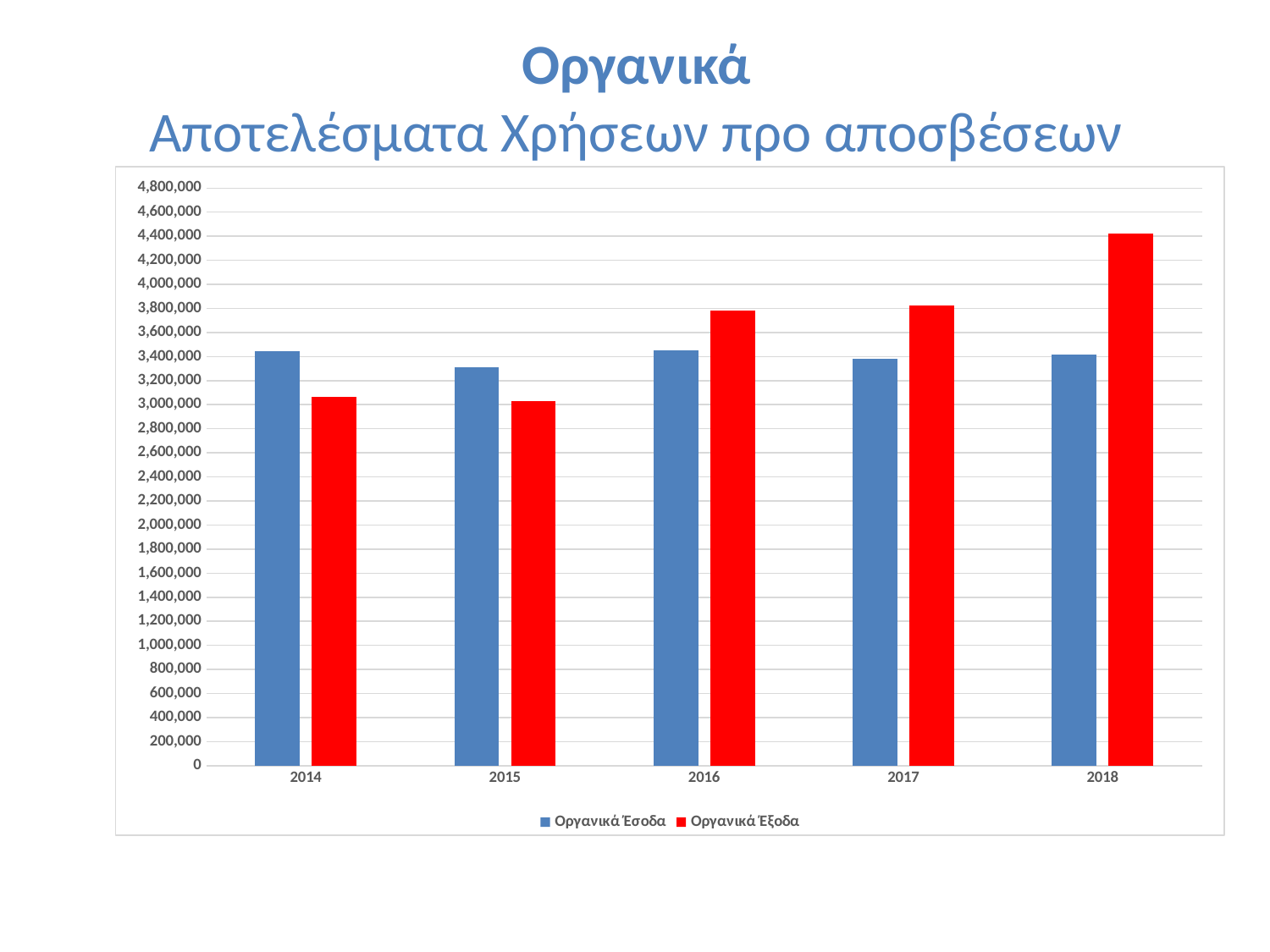
How many years are shown on the x axis of the chart? 5 How many series does the legend list? 2 In 2014, which is larger: Οργανικά Έσοδα or Οργανικά Έξοδα? Οργανικά Έσοδα In 2018, which is larger: Οργανικά Έσοδα or Οργανικά Έξοδα? Οργανικά Έξοδα What kind of chart is shown on the slide? bar chart In which year is the value for Οργανικά Έξοδα highest? 2018 Is the value for Οργανικά Έξοδα in 2018 greater or less than 4,200,000? greater Which series is shown in red in the chart? Οργανικά Έξοδα Is the value for Οργανικά Έξοδα in 2014 greater or less than 3,200,000? less Is the value for Οργανικά Έσοδα in 2017 greater or less than 3,600,000? less Do the values for Οργανικά Έξοδα rise or fall from 2015 to 2018? rise